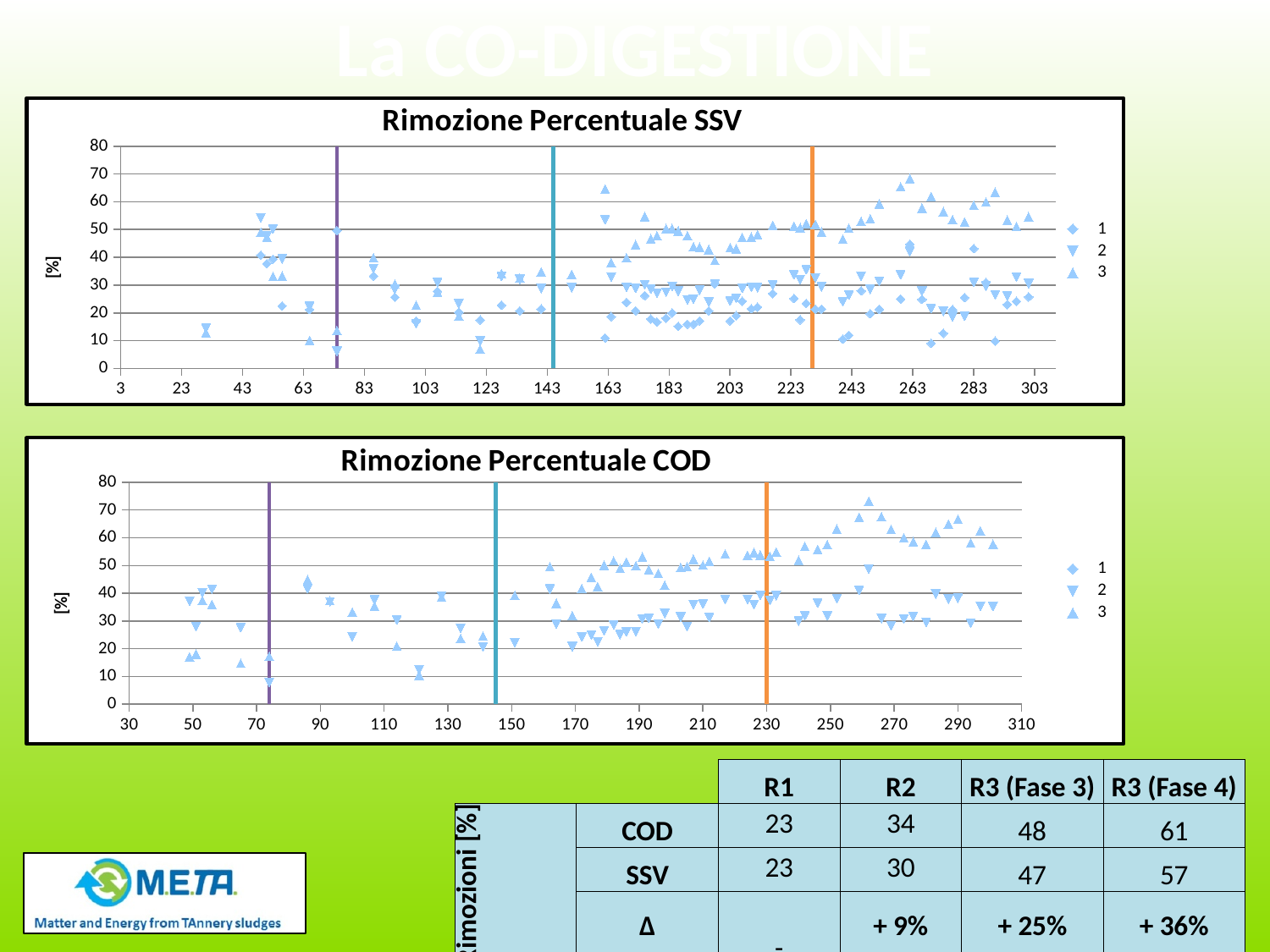
How many series does the legend of the 'Rimozione Percentuale SSV' chart list? 3 What are the legend entries of the 'Rimozione Percentuale COD' chart? 1, 2, 3 What kind of chart is the 'Rimozione Percentuale COD' chart? Scatter chart What is the y-axis label of the 'Rimozione Percentuale SSV' chart? [%] In the 'Rimozione Percentuale SSV' chart, is the highest plotted point greater or less than 60? greater In the 'Rimozione Percentuale COD' chart, is the highest plotted point greater or less than 60? greater How many series does the legend of the 'Rimozione Percentuale COD' chart list? 3 In the 'Rimozione Percentuale COD' chart, do the values of series 3 generally rise or fall as the x axis increases from 170 to 270? rise What kind of chart is the 'Rimozione Percentuale SSV' chart? Scatter chart